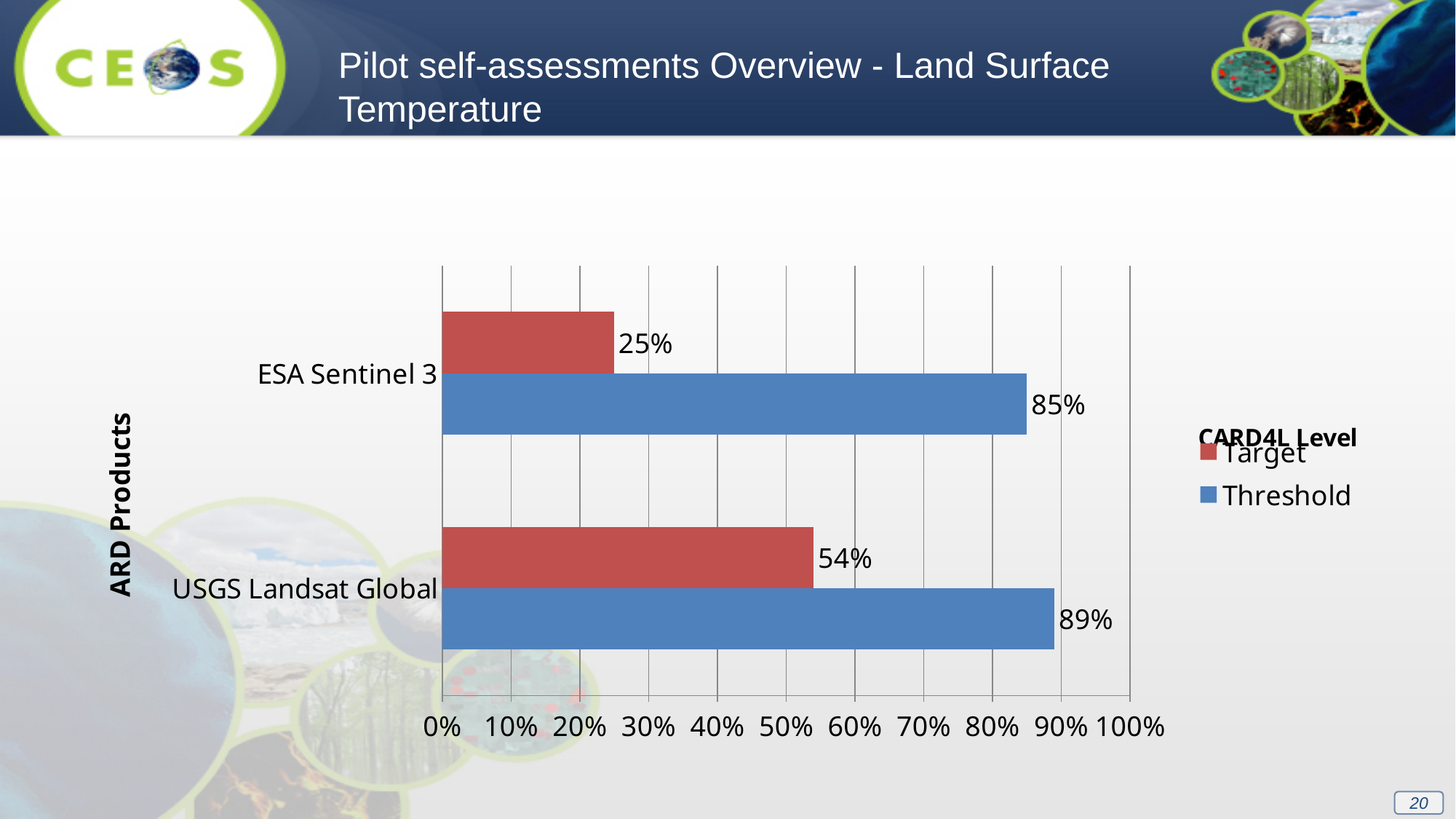
What is the difference between the Target values for USGS Landsat Global and ESA Sentinel 3? 29% What is the Threshold value for ESA Sentinel 3? 85% What is the Threshold value for USGS Landsat Global? 89% Which ARD product has the lower Threshold value? ESA Sentinel 3 What is the difference between the Threshold and Target values for ESA Sentinel 3? 60% Which ARD product has the higher Target value? USGS Landsat Global What kind of chart is shown on the slide? Bar chart What is the Target value for ESA Sentinel 3? 25% How many ARD products are shown on the chart? 2 What is the Target value for USGS Landsat Global? 54% Is the Threshold value for USGS Landsat Global larger than the Threshold value for ESA Sentinel 3? Yes How many series does the legend list? 2